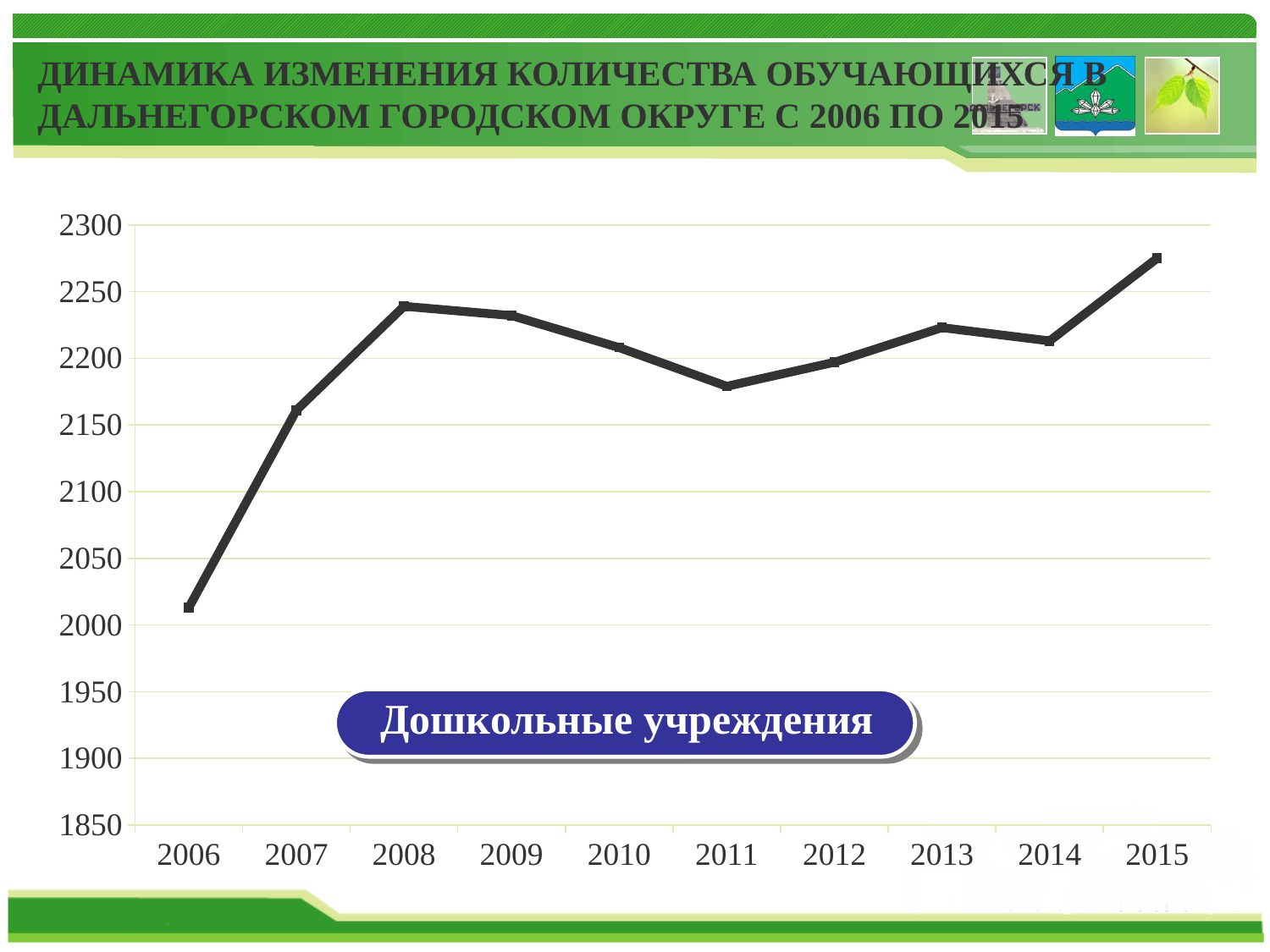
What label is shown in the blue box on the chart? Дошкольные учреждения How many years are plotted along the x axis? 10 In which year is the number of pupils highest? 2015 Is the value for 2008 greater or less than 2200? greater What kind of chart is shown on the slide? line chart Does the line rise or fall from 2008 to 2011? fall Is the value for 2006 greater or less than 2050? less Is the value for 2015 greater or less than 2250? greater Which year has the larger value, 2008 or 2011? 2008 In which year is the number of pupils lowest? 2006 Does the line rise or fall from 2006 to 2008? rise